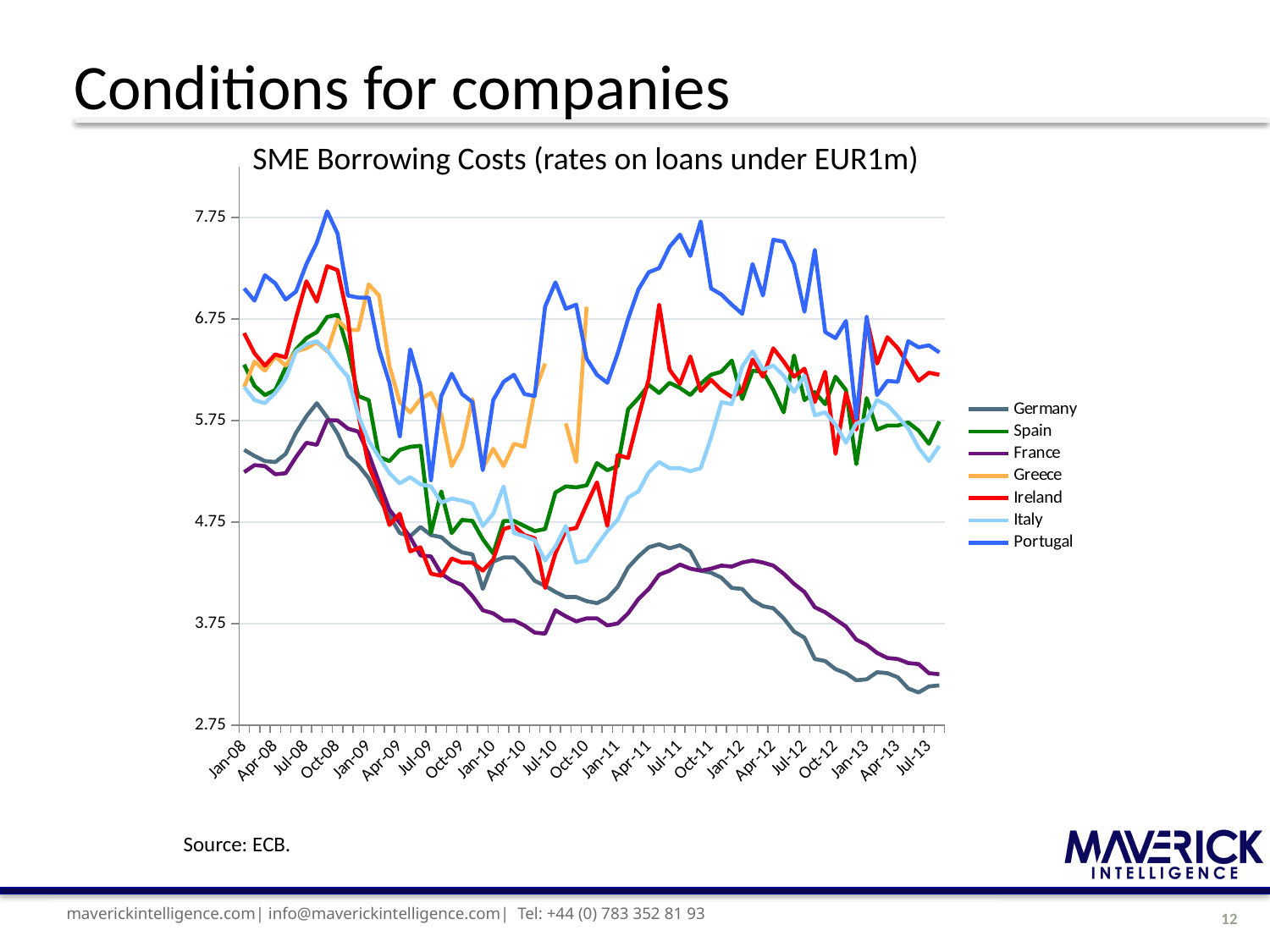
Is the value for Ireland at Jan-08 greater or less than 5.75? greater Which series has the lowest value at Jan-12? Germany Is the value for France at Jul-13 greater or less than 3.75? less What kind of chart is shown on the slide? Line chart Which series has the highest value at Jul-11? Portugal Is the value for Spain at Jul-13 greater or less than 4.75? greater Which country is shown in orange in the legend? Greece Does the Germany series rise or fall overall from Jan-08 to Jul-13? Fall What is the title of the chart? SME Borrowing Costs (rates on loans under EUR1m) How many series does the legend list? 7